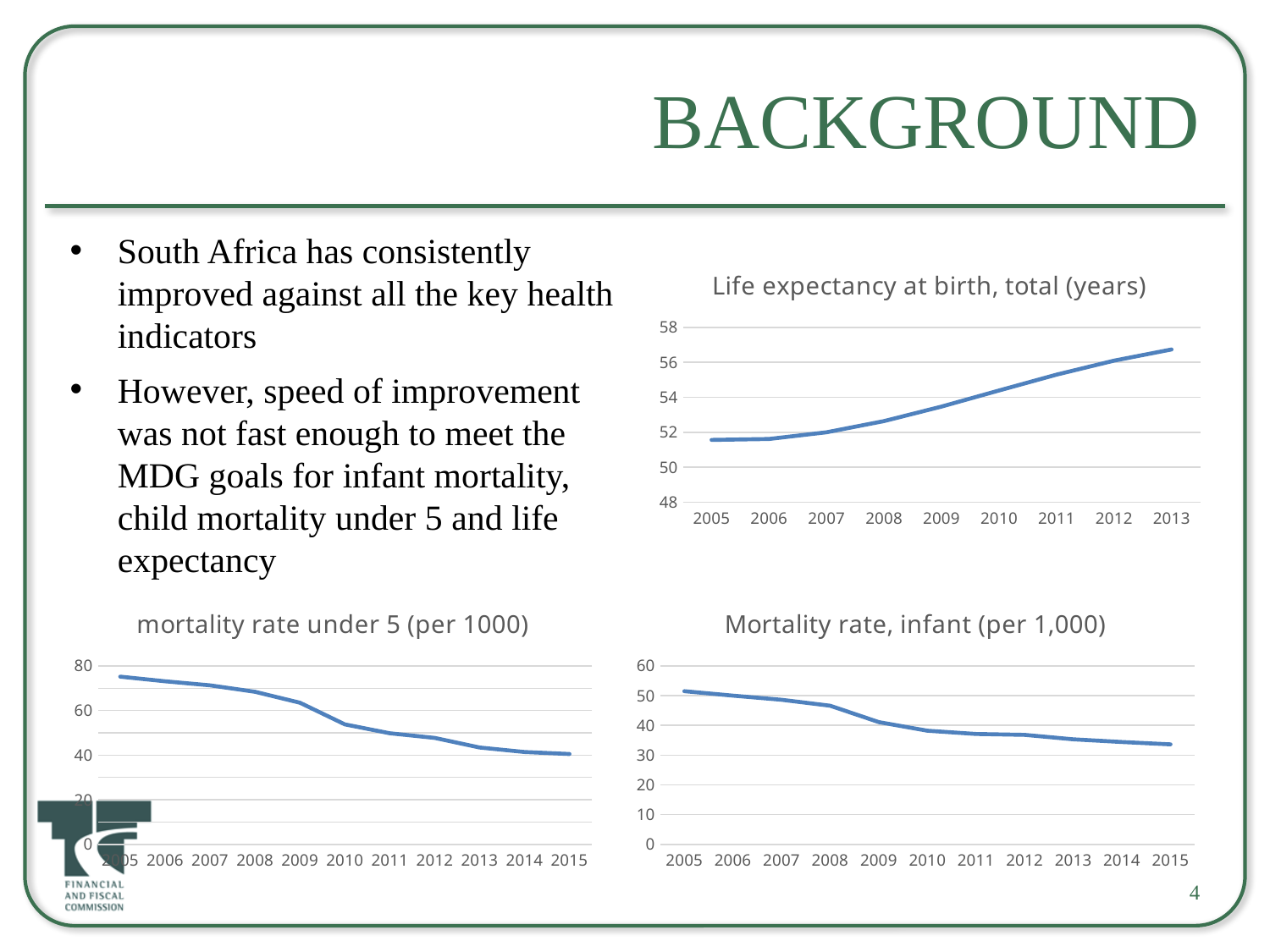
In the 'Life expectancy at birth, total (years)' chart, which year has the highest value? 2013 In the 'mortality rate under 5 (per 1000)' chart, is the value for 2005 greater or less than 60? greater How many charts are shown on the slide? 3 In the 'mortality rate under 5 (per 1000)' chart, do the values rise or fall from 2005 to 2015? fall In the 'Life expectancy at birth, total (years)' chart, is the value for 2013 greater or less than 56? greater In the 'Life expectancy at birth, total (years)' chart, do the values rise or fall from 2005 to 2013? rise What kind of chart is the 'Life expectancy at birth, total (years)' chart? line chart In the 'Mortality rate, infant (per 1,000)' chart, which year has the lowest value? 2015 How many years are shown on the x axis of the 'Life expectancy at birth, total (years)' chart? 9 In the 'Mortality rate, infant (per 1,000)' chart, is the value for 2015 greater or less than 40? less How many years are shown on the x axis of the 'Mortality rate, infant (per 1,000)' chart? 11